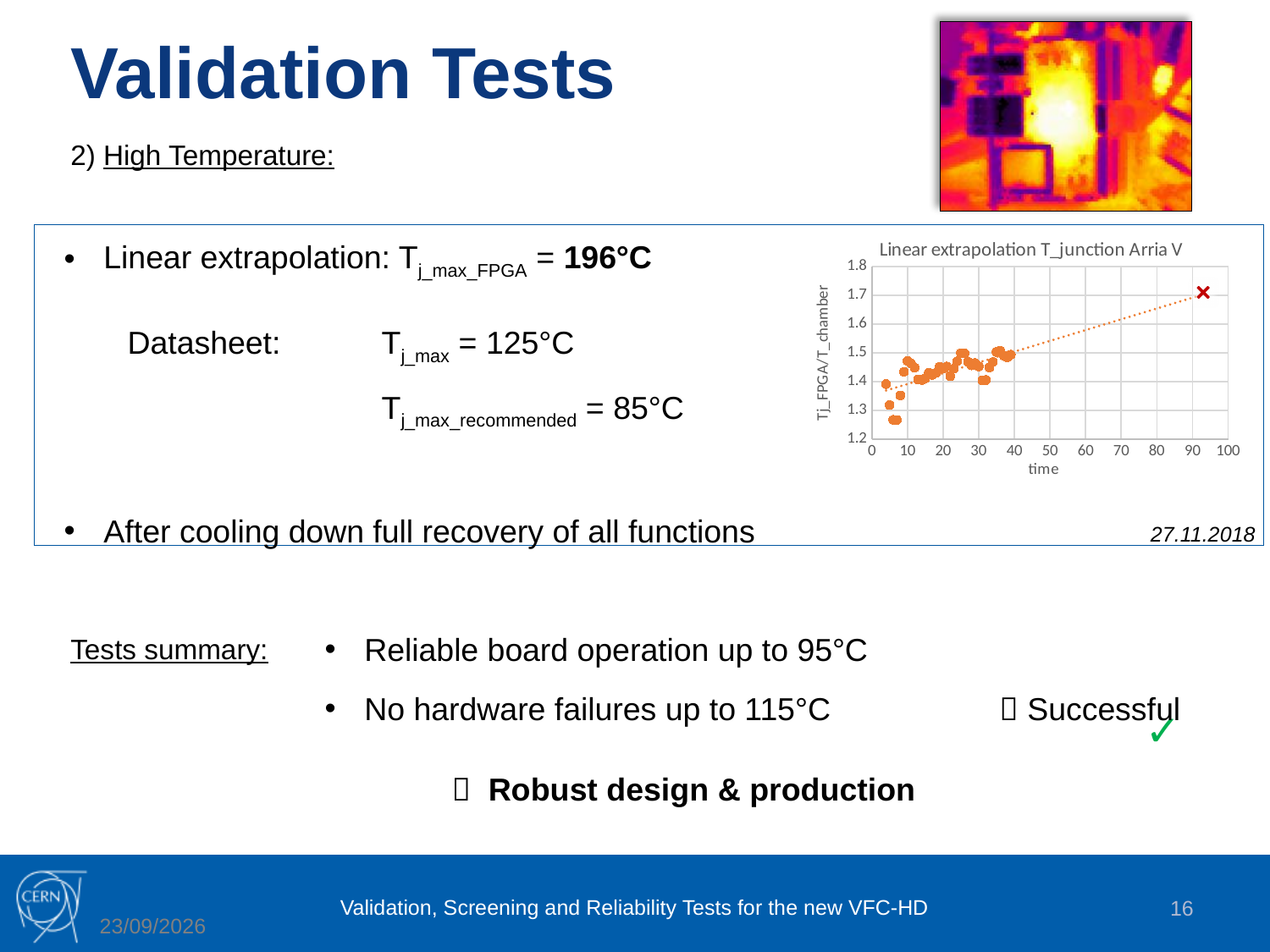
Do the plotted values in the chart generally rise or fall as time increases? rise What kind of chart is shown on the slide? scatter chart What is the title of the chart on the slide? Linear extrapolation T_junction Arria V Is the red X marker in the chart located at a time greater or less than 80? greater Is the value marked by the red X in the chart greater or less than 1.8? less What is the label of the x axis of the chart? time Is the value marked by the red X in the chart greater or less than 1.6? greater What is the maximum value shown on the y axis of the chart? 1.8